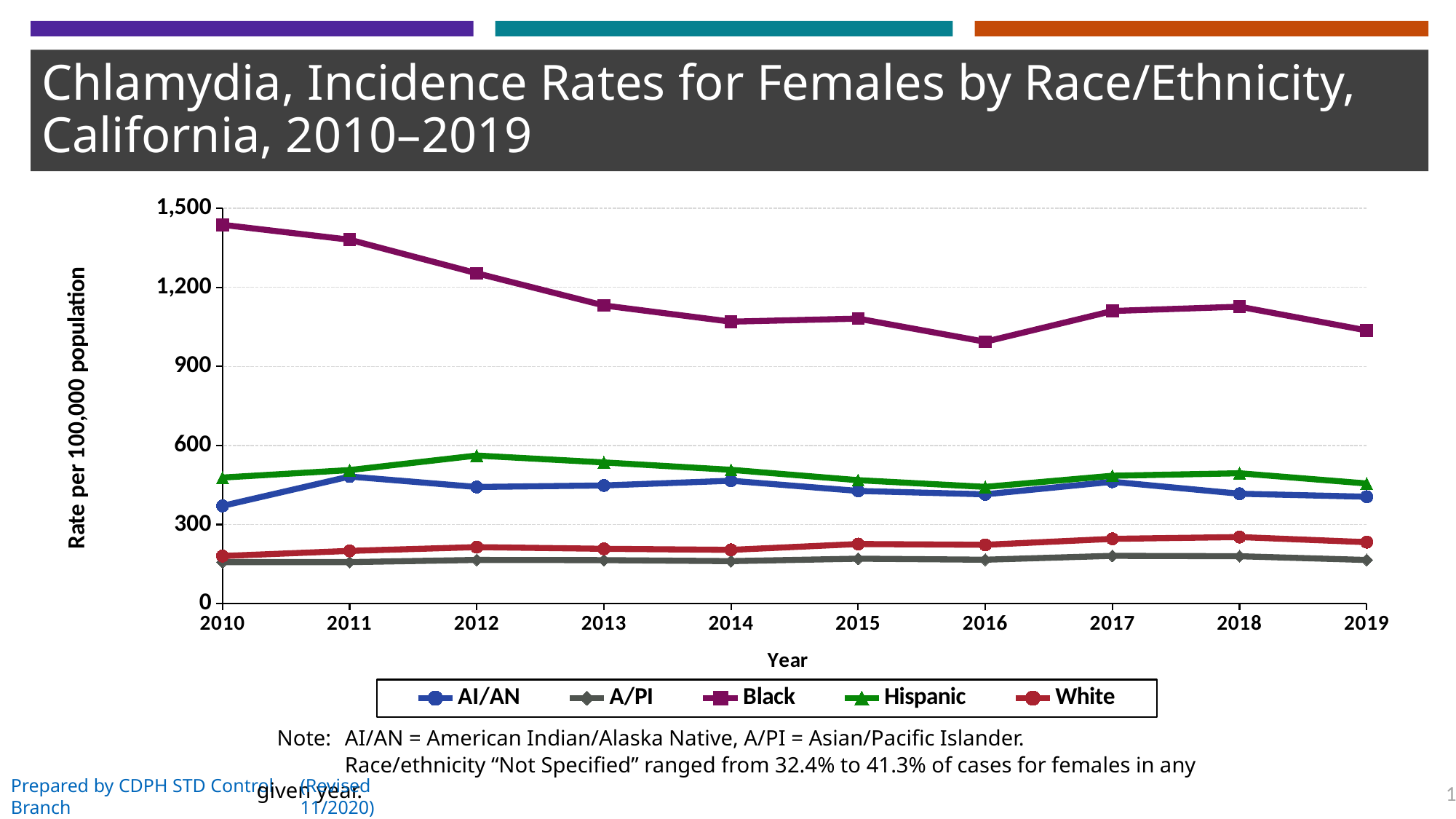
Is the value for Black in 2010 greater or less than 1,200? greater Is the value for White in 2018 greater or less than 300? less What is the label of the y axis? Rate per 100,000 population How many years are plotted along the x axis? 10 What kind of chart is shown on the slide? Line chart Is the value for Black in 2013 greater or less than 1,200? less In 2012, which is larger: the value for Hispanic or the value for AI/AN? Hispanic Which race/ethnicity group has the lowest incidence rate across the years shown? A/PI Does the Black series rise or fall from 2010 to 2016? Fall How many series does the legend list? 5 Which race/ethnicity group has the highest incidence rate in every year shown? Black